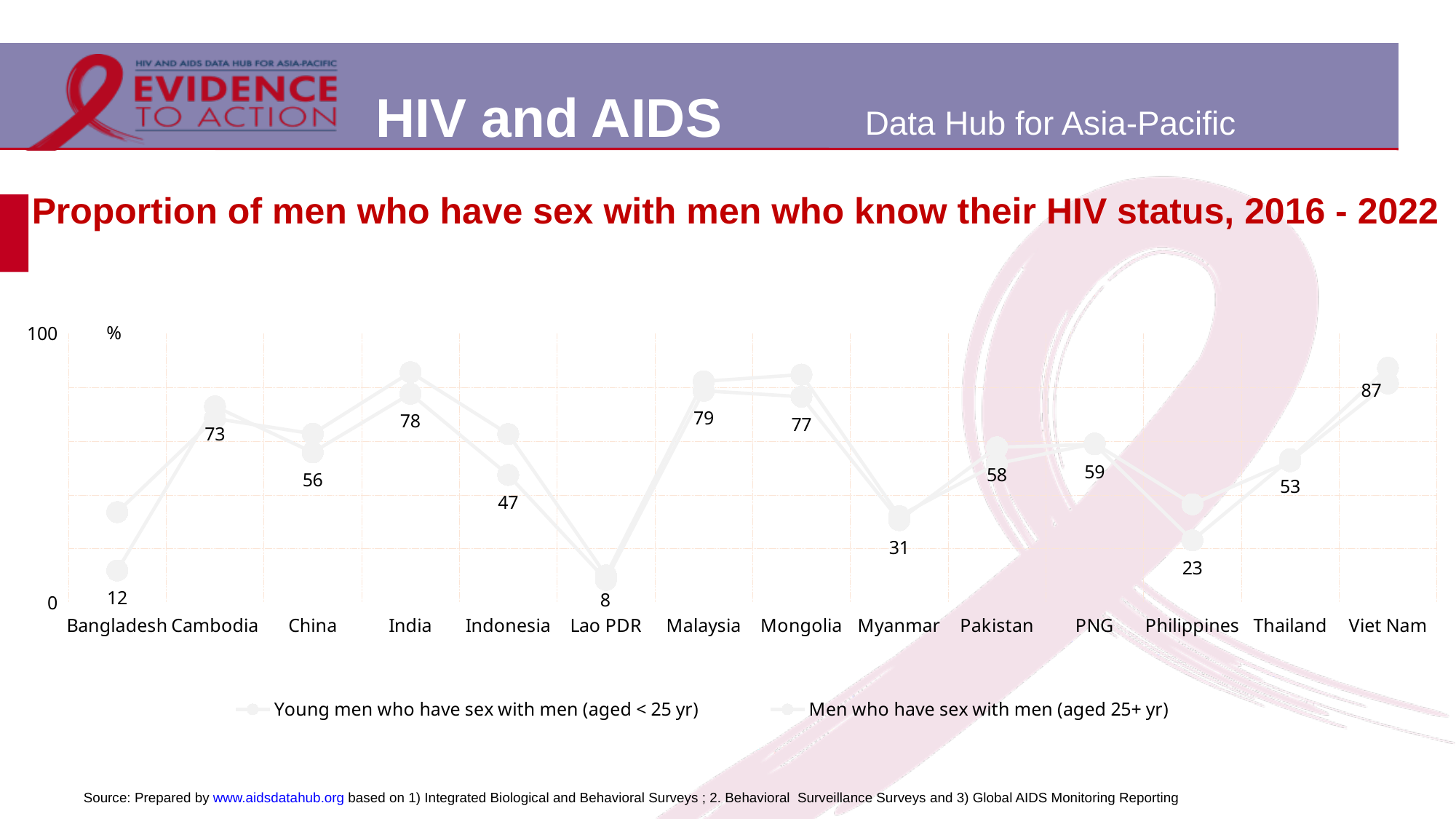
What is the data label shown for Viet Nam? 87 What is the data label shown for Indonesia? 47 Which country has the highest labelled value on the chart? Viet Nam What is the data label shown for Myanmar? 31 How many series does the chart legend list? 2 Which country has the lowest labelled value on the chart? Lao PDR What is the data label shown for Lao PDR? 8 What kind of chart is shown on the slide? Line chart What is the first series listed in the chart legend? Young men who have sex with men (aged < 25 yr) How many countries are shown along the x axis of the chart? 14 Which has the larger labelled value, Malaysia or Mongolia? Malaysia What is the difference between the labelled values for Cambodia and China? 17